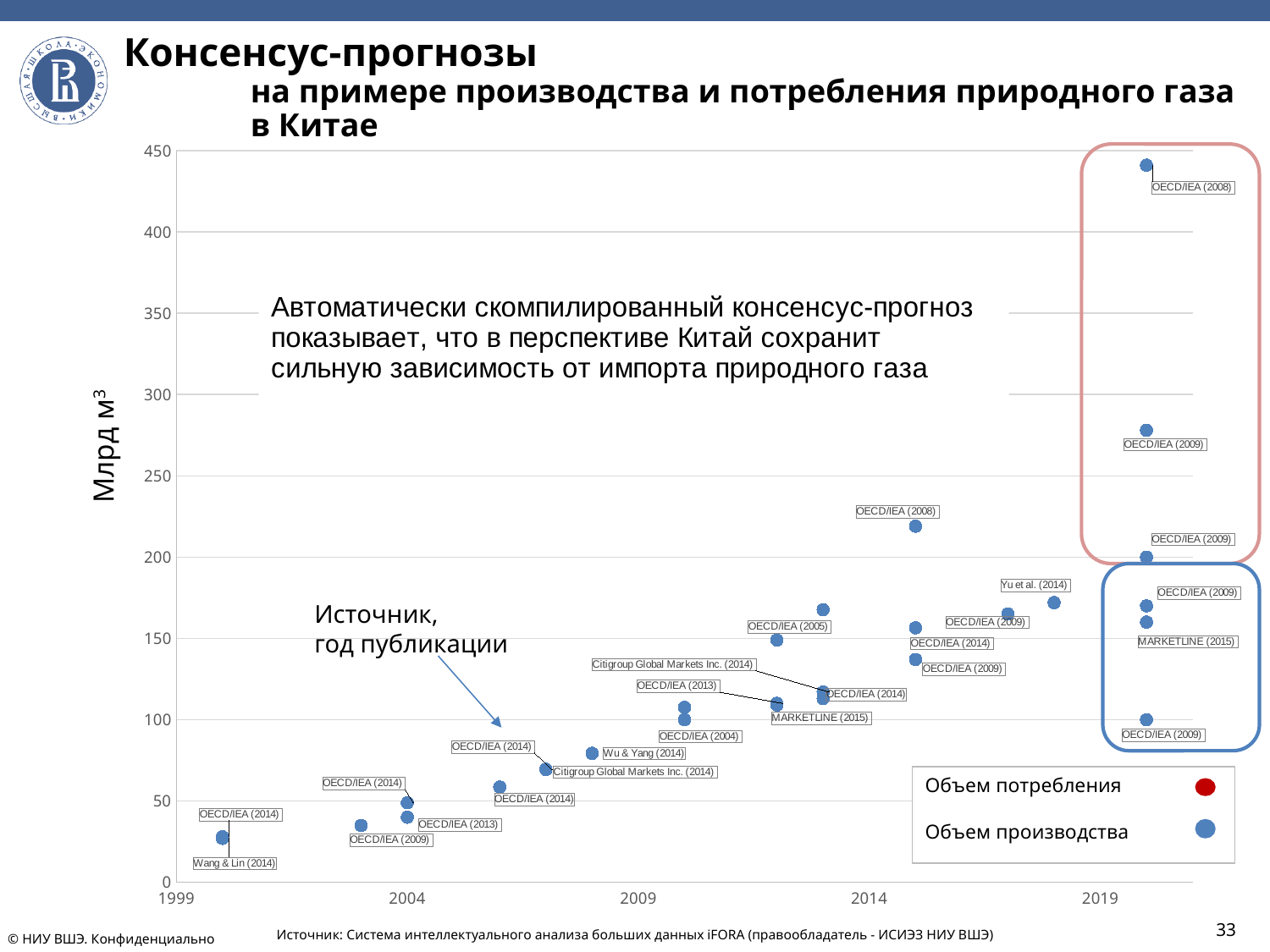
How many series does the legend list? 2 Is the value of the point labelled OECD/IEA (2009) near 280 on the right side greater or less than 250? greater What is the label of the vertical axis? Млрд м³ Is the value of the point labelled Wang & Lin (2014) greater or less than 50? less Do the plotted values generally rise or fall as the year increases along the x axis? rise Is the value of the point labelled OECD/IEA (2008) near the year 2015 greater or less than 200? greater What are the two series named in the legend? Объем потребления, Объем производства What kind of chart is shown on the slide? Scatter chart Which source label is attached to the highest point on the chart? OECD/IEA (2008)